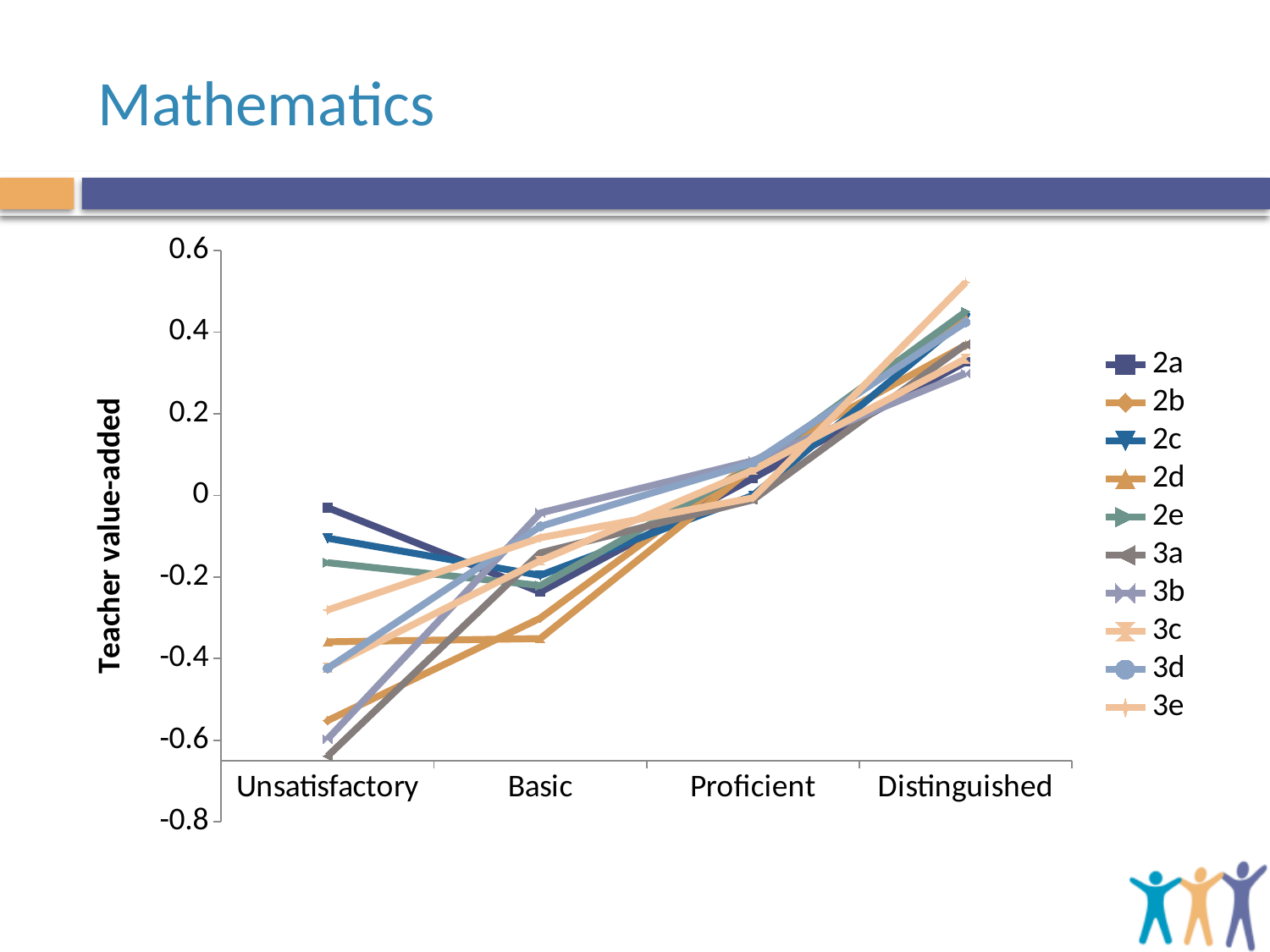
Is the value for series 2b at Unsatisfactory greater or less than -0.4? less Is the value for series 2a at Distinguished greater or less than 0.2? greater What kind of chart is shown on the slide? line chart What is the label of the vertical axis? Teacher value-added Which series has the highest value at Unsatisfactory? 2a Is the value for series 2a at Unsatisfactory greater or less than -0.2? greater Do the values for series 2b rise or fall from Unsatisfactory to Distinguished? rise How many categories are shown on the x axis? 4 Which category is furthest right on the x axis? Distinguished How many series does the legend list? 10